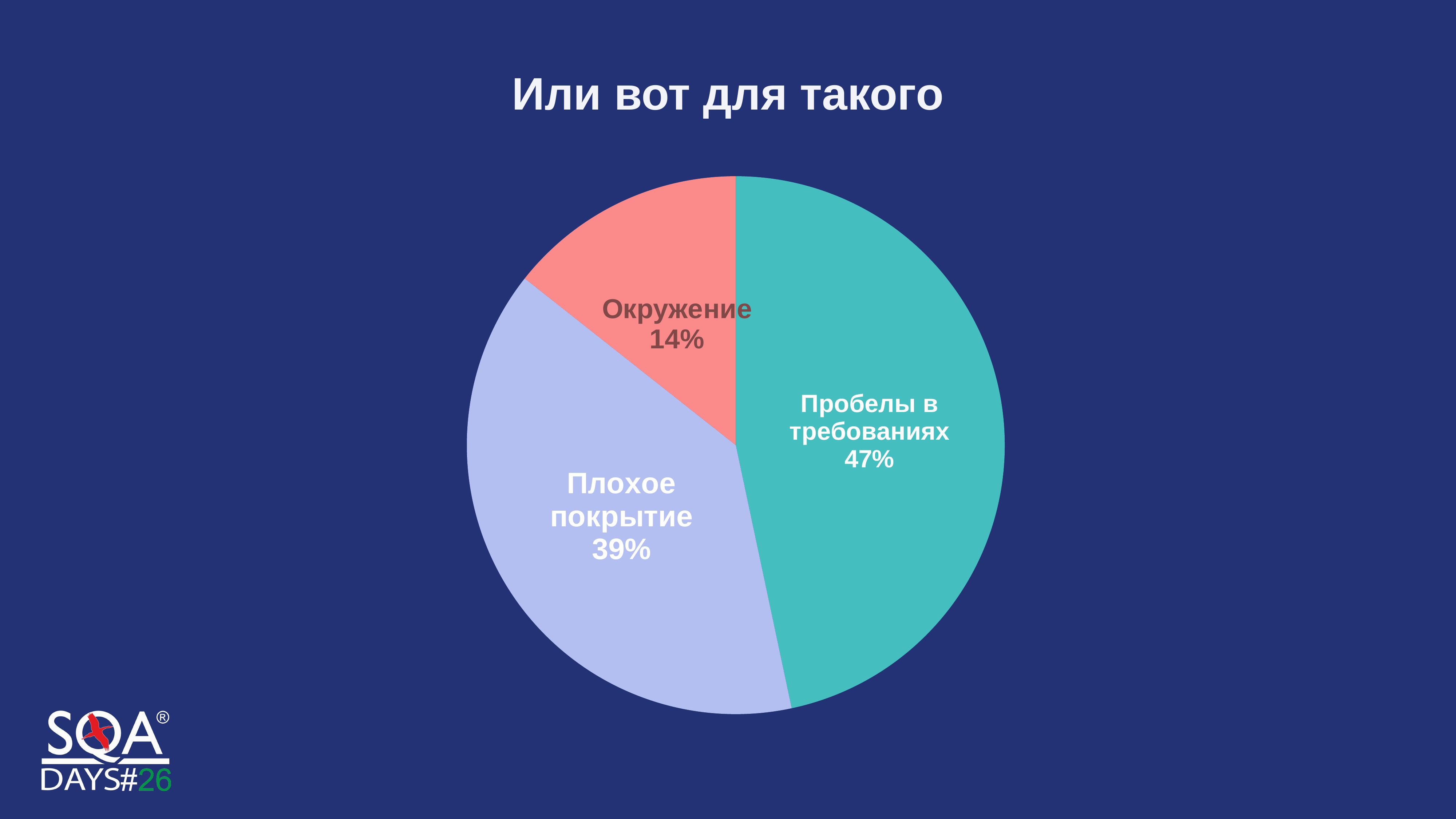
What kind of chart is shown on the slide? pie chart What share of the pie does "Окружение" have? 14% How many slices does the pie chart have? 3 What colour is the "Окружение" slice of the pie? pink (salmon) Which slice of the pie is the smallest? Окружение Which is larger, the share for "Окружение" or the share for "Плохое покрытие"? Плохое покрытие What share of the pie does "Плохое покрытие" have? 39% What is the title of the slide containing the pie chart? Или вот для такого What share of the pie does "Пробелы в требованиях" have? 47% What is the difference in percentage points between "Пробелы в требованиях" and "Плохое покрытие"? 8 What is the difference in percentage points between "Плохое покрытие" and "Окружение"? 25 Which slice of the pie is the largest? Пробелы в требованиях